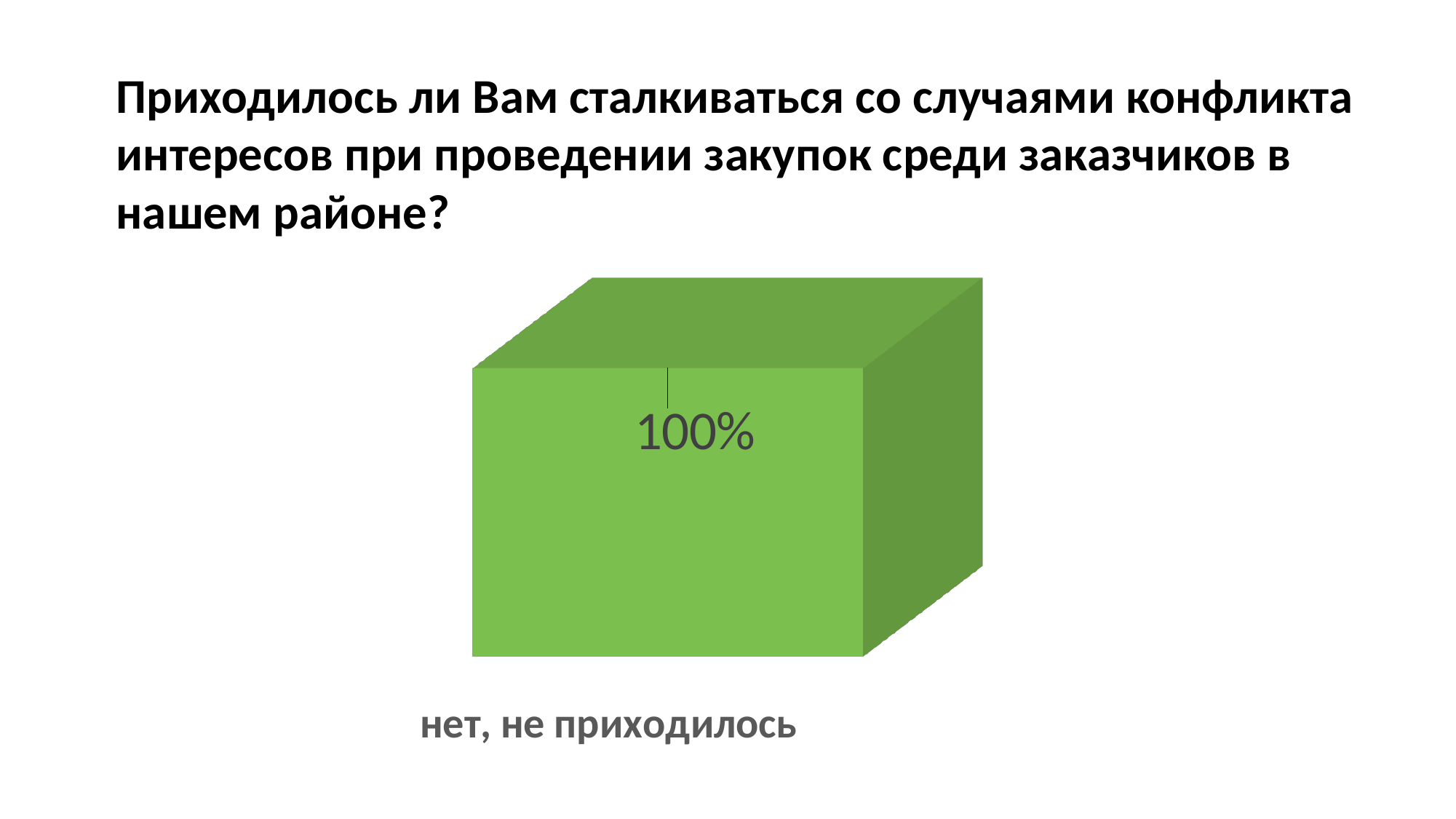
What is the label of the only category in the chart? нет, не приходилось Is the value for "нет, не приходилось" greater or less than 50%? greater What colour is the bar in the chart? green What kind of chart is shown on the slide? bar chart How many categories are plotted in the chart? 1 What value is shown for the category "нет, не приходилось"? 100%